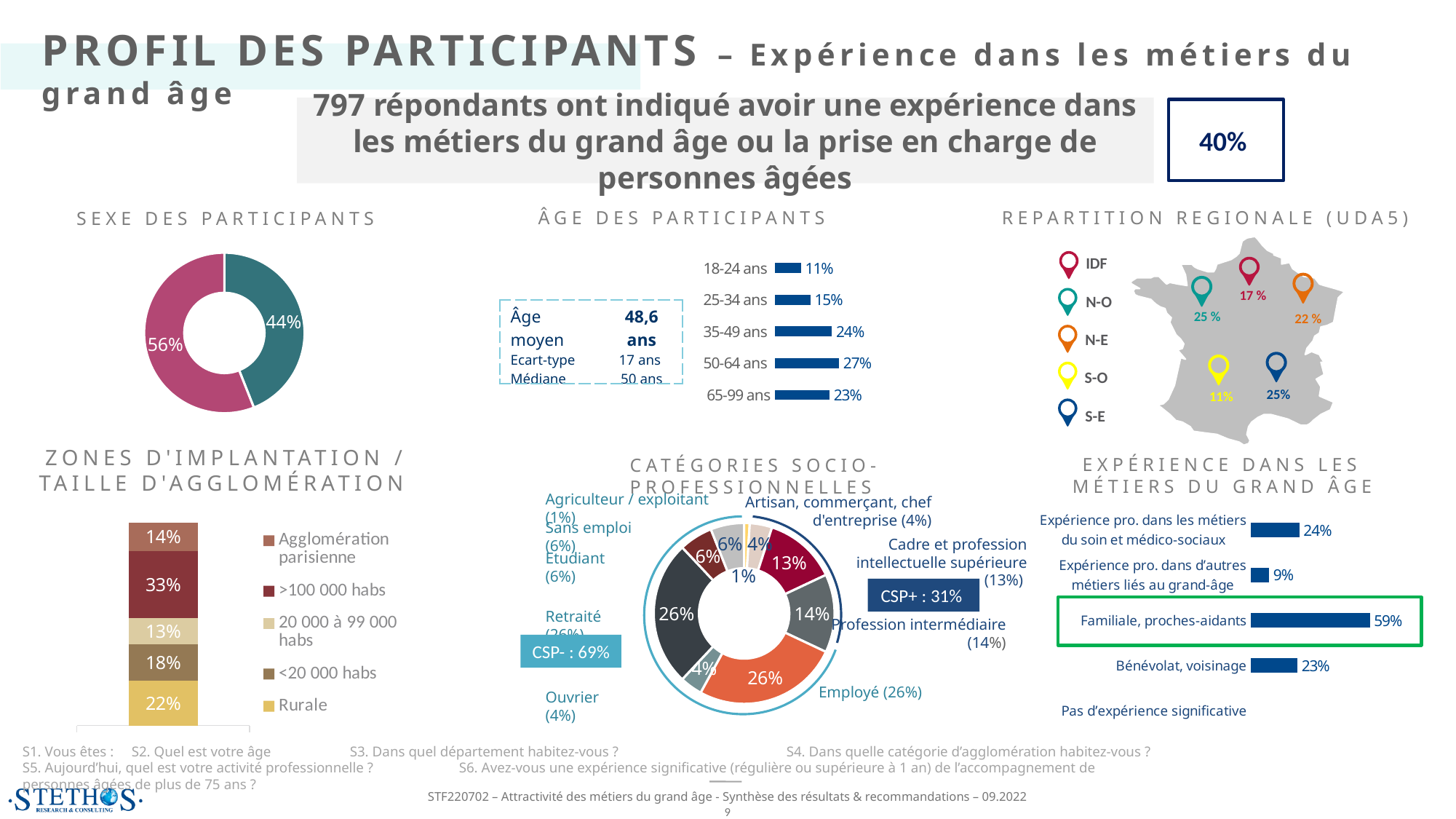
In the 'Âge des participants' chart, what is the difference between the values for 35-49 ans and 25-34 ans? 9% In the 'Âge des participants' chart, what is the value for 50-64 ans? 27% In the 'Zones d'implantation / taille d'agglomération' stacked bar, what is the value for '>100 000 habs'? 33% In the 'Sexe des participants' donut chart, what is the value of the larger slice? 56% In the 'Expérience dans les métiers du grand âge' chart, which category has the lowest printed value? Expérience pro. dans d'autres métiers liés au grand-âge In the 'Catégories socio-professionnelles' donut chart, what is the value for 'Retraité'? 26% What type of chart is used for 'Âge des participants'? Bar chart In the 'Âge des participants' chart, which age group has the highest value? 50-64 ans In the 'Expérience dans les métiers du grand âge' chart, what is the value for 'Familiale, proches-aidants'? 59% In the 'Zones d'implantation / taille d'agglomération' chart, how many categories does the legend list? 5 In the 'Âge des participants' chart, how many age groups are shown? 5 In the 'Âge des participants' chart, which age group has the lowest value? 18-24 ans